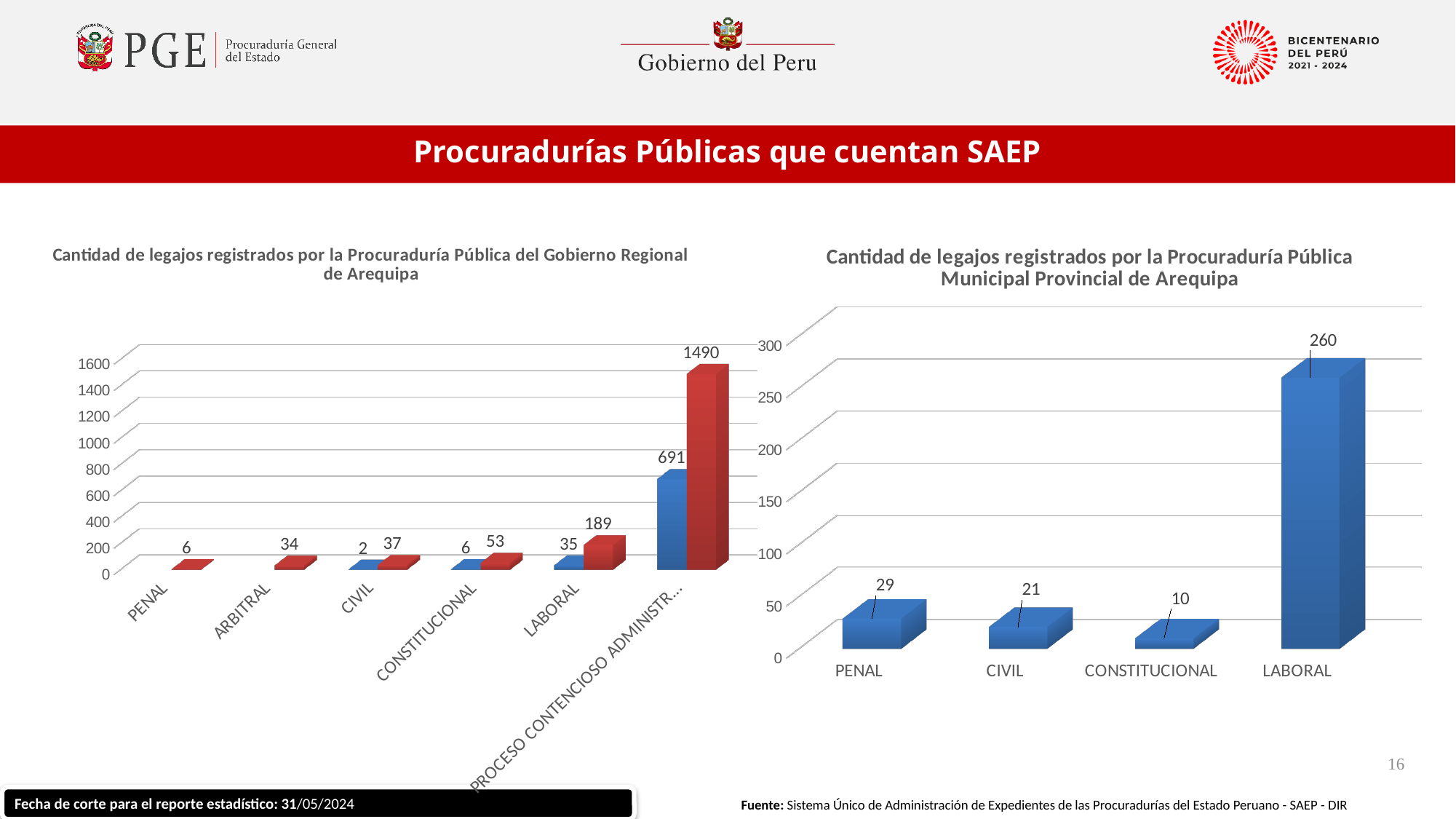
In the chart on the right (Procuraduría Pública Municipal Provincial de Arequipa), what is the value for LABORAL? 260 In the chart on the left (Procuraduría Pública del Gobierno Regional de Arequipa), what is the difference between the red bar and the blue bar for CONSTITUCIONAL? 47 In the chart on the right (Procuraduría Pública Municipal Provincial de Arequipa), what is the value for PENAL? 29 In the chart on the right (Procuraduría Pública Municipal Provincial de Arequipa), what is the difference between LABORAL and CIVIL? 239 In the chart on the right (Procuraduría Pública Municipal Provincial de Arequipa), which category has the lowest value? CONSTITUCIONAL In the chart on the right (Procuraduría Pública Municipal Provincial de Arequipa), how many categories are shown on the x axis? 4 In the chart on the left (Procuraduría Pública del Gobierno Regional de Arequipa), what is the value of the blue bar for PROCESO CONTENCIOSO ADMINISTR...? 691 In the chart on the left (Procuraduría Pública del Gobierno Regional de Arequipa), what is the value of the red bar for LABORAL? 189 In the chart on the right (Procuraduría Pública Municipal Provincial de Arequipa), which is larger, PENAL or CIVIL? PENAL In the chart on the left (Procuraduría Pública del Gobierno Regional de Arequipa), what is the value of the red bar for ARBITRAL? 34 In the chart on the left (Procuraduría Pública del Gobierno Regional de Arequipa), what is the highest value shown on any bar? 1490 What type of chart is used on the right side of the slide (Procuraduría Pública Municipal Provincial de Arequipa)? Bar chart